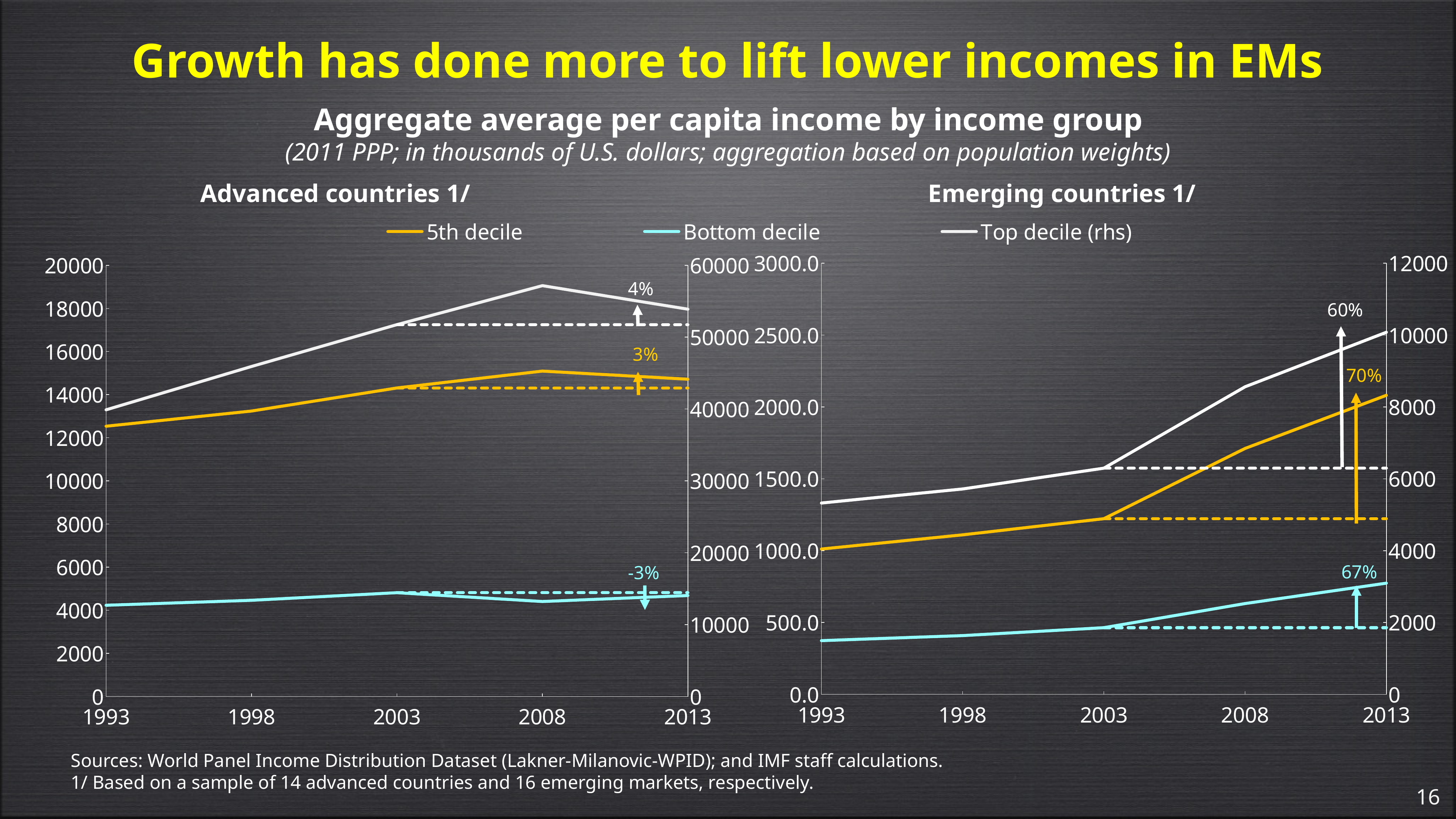
How many series does the legend list for the charts? 3 What is the difference between the annotated percentage change for the Bottom decile in the Emerging countries chart and in the Advanced countries chart? 70 percentage points In the Advanced countries chart, what percentage change is annotated for the Top decile (rhs) line? 4% In the Emerging countries chart, which series has the largest annotated percentage change? 5th decile In the Advanced countries chart, which series has the lowest annotated percentage change? Bottom decile In the Advanced countries chart, does the 5th decile line rise or fall between 2008 and 2013? fall In the Emerging countries chart, what percentage change is annotated for the Top decile (rhs) line? 60% In the Advanced countries chart, is the 5th decile value in 2013 larger or smaller than the Bottom decile value in 2013? larger In the Emerging countries chart, what percentage change is annotated for the 5th decile line? 70% In the Advanced countries chart, what percentage change is annotated for the Bottom decile line? -3% In the Emerging countries chart, is the Bottom decile value in 2013 greater or less than 500.0 on the left axis? greater What kind of chart is the Emerging countries chart? line chart